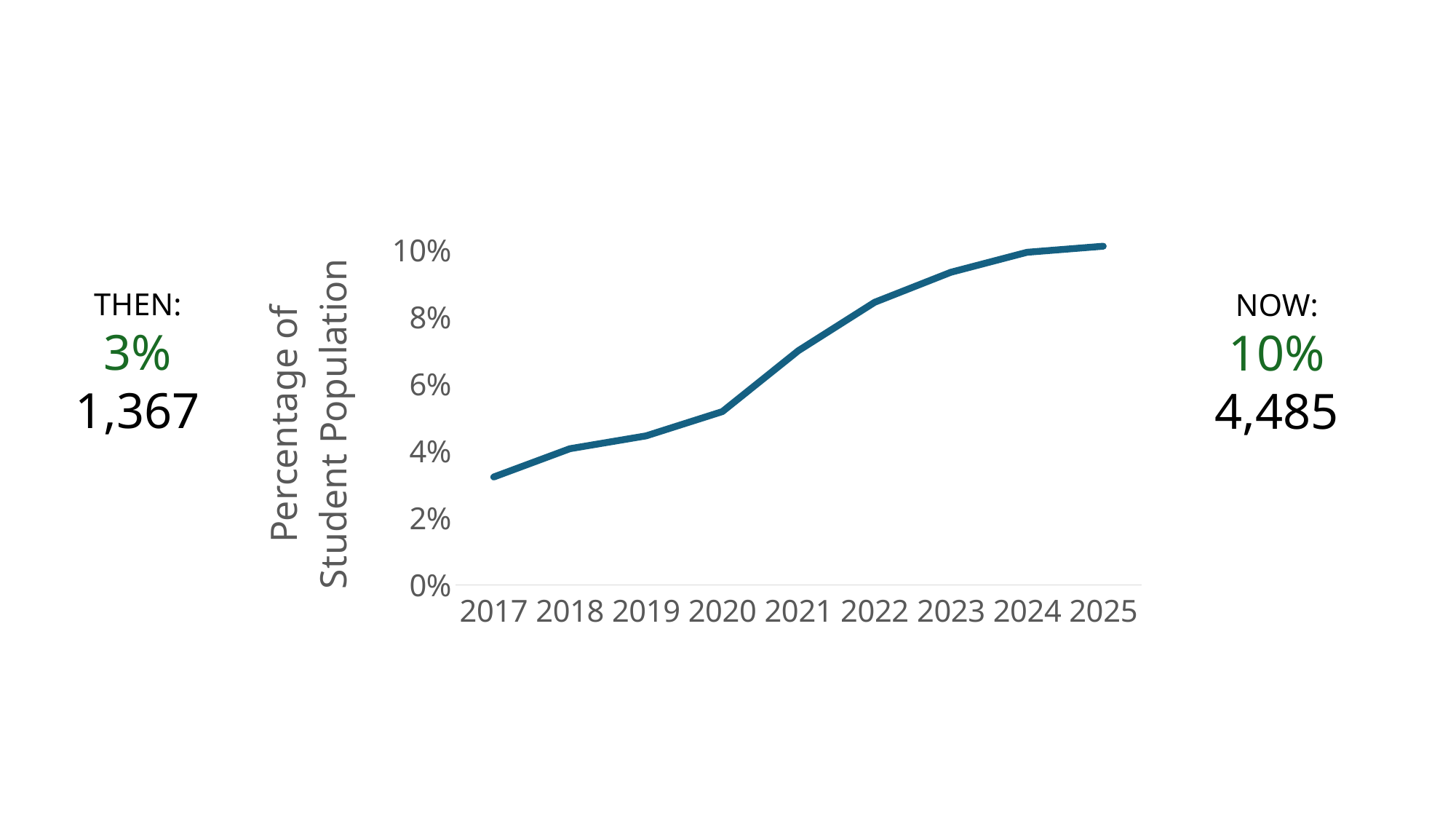
What percentage is shown next to the 'NOW:' label beside the chart? 10% Is the value for 2017 greater or less than 4%? less Is the value for 2019 greater or less than 6%? less Is the value for 2020 greater or less than 4%? greater Which year has the lowest percentage of student population? 2017 What is the title of the vertical axis of the chart? Percentage of Student Population Does the percentage of student population rise or fall from 2017 to 2025? rise Which year has the larger value, 2019 or 2022? 2022 How many years are plotted along the x axis of the chart? 9 What kind of chart is shown on the slide? line chart